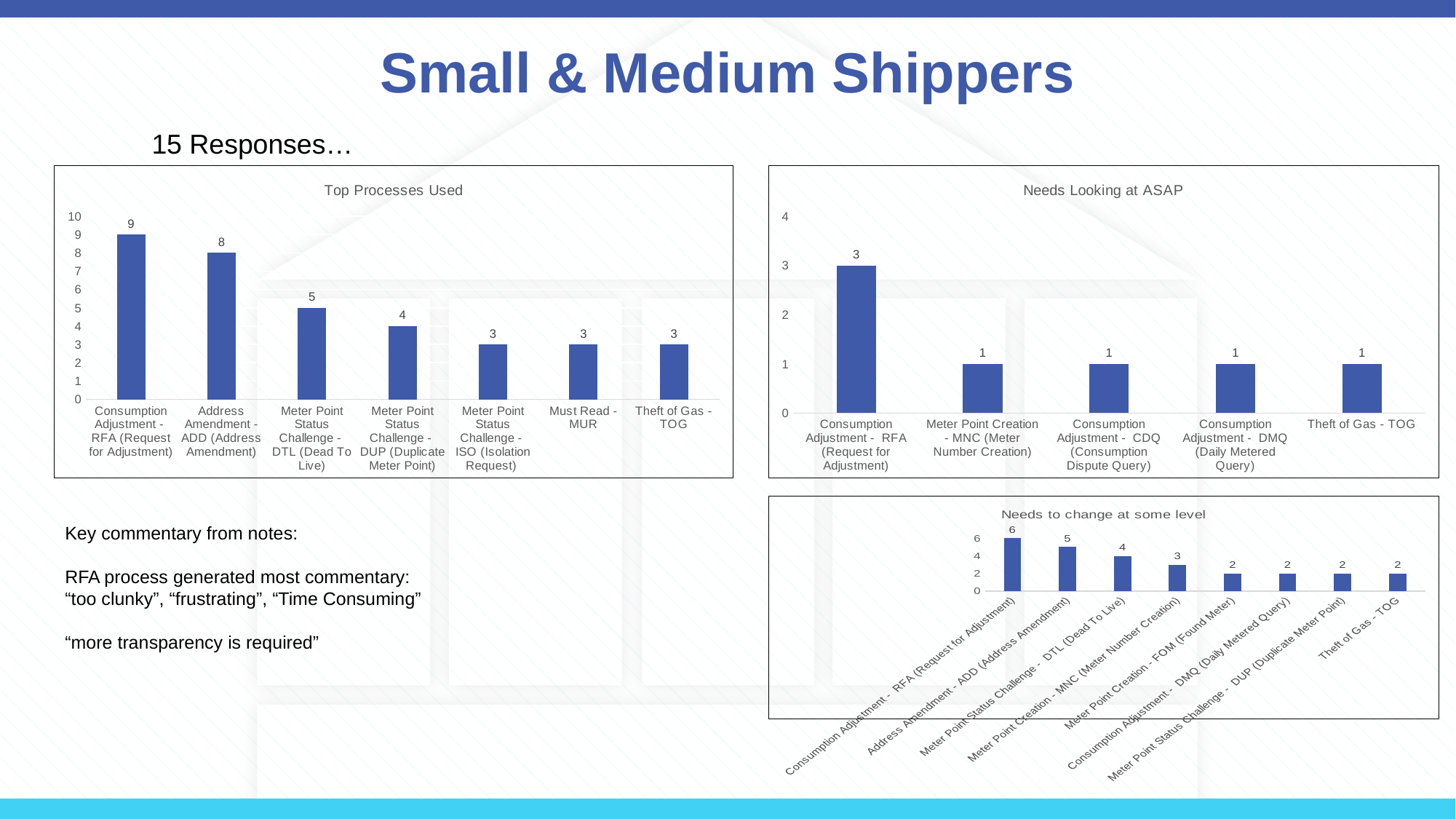
What type of chart is the 'Top Processes Used' chart? Bar chart In the 'Needs to change at some level' chart, what is the value for Meter Point Creation - MNC (Meter Number Creation)? 3 In the 'Top Processes Used' chart, what is the difference between the values for Consumption Adjustment - RFA and Meter Point Status Challenge - DTL (Dead To Live)? 4 How many categories are shown in the 'Needs to change at some level' chart? 8 In the 'Needs Looking at ASAP' chart, what is the value for Consumption Adjustment - RFA (Request for Adjustment)? 3 In the 'Top Processes Used' chart, what is the value for Address Amendment - ADD (Address Amendment)? 8 How many categories are shown in the 'Top Processes Used' chart? 7 How many categories are shown in the 'Needs Looking at ASAP' chart? 5 In the 'Needs Looking at ASAP' chart, what is the value for Theft of Gas - TOG? 1 In the 'Needs to change at some level' chart, which category has the highest value? Consumption Adjustment - RFA (Request for Adjustment) In the 'Top Processes Used' chart, which category has the highest value? Consumption Adjustment - RFA (Request for Adjustment) In the 'Top Processes Used' chart, what is the value for Meter Point Status Challenge - DUP (Duplicate Meter Point)? 4